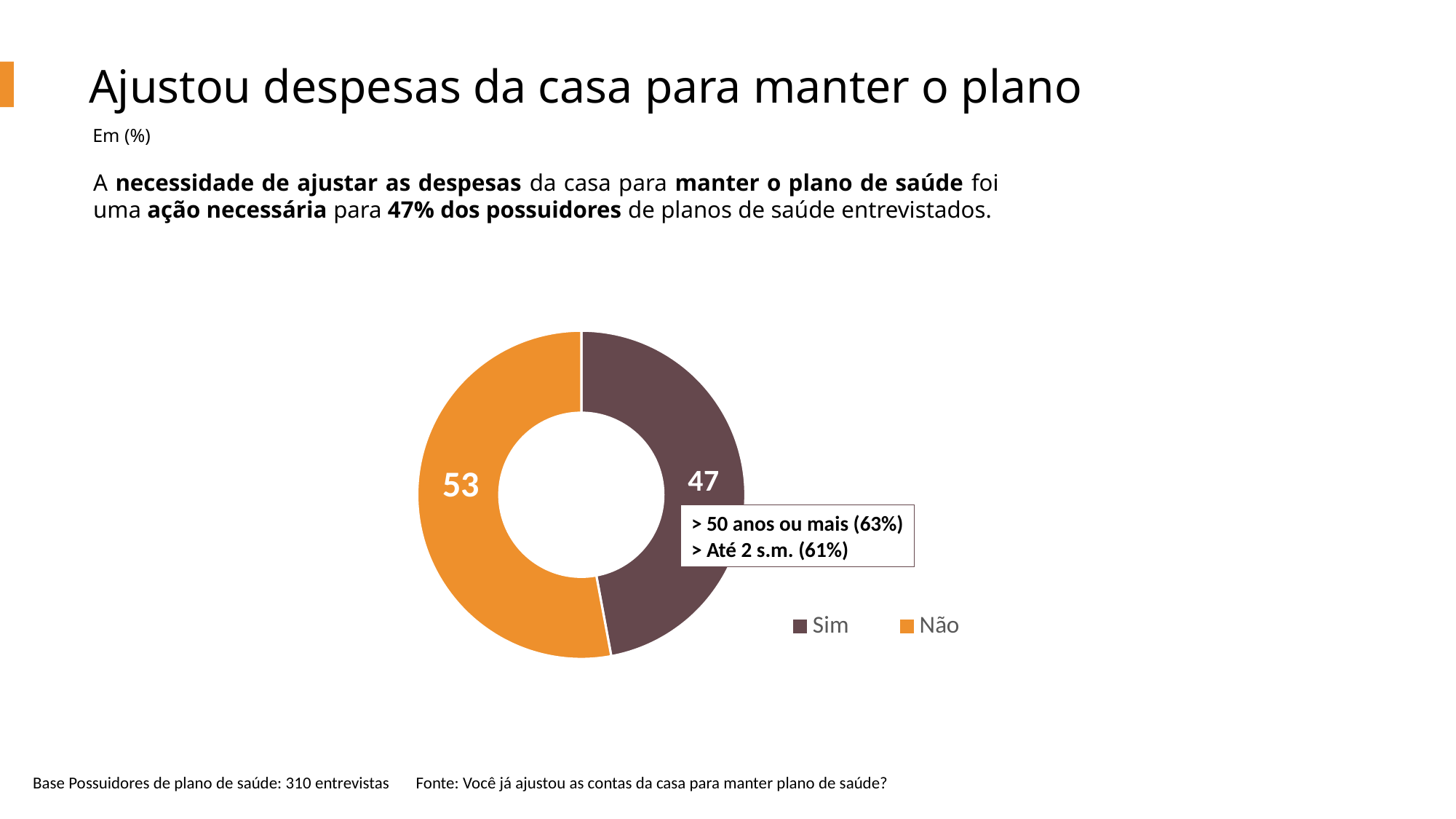
How many categories does the chart show? 2 How many entries does the legend list? 2 What is the total of the two values shown in the chart? 100 What is the value for Sim? 47 Which category has the smallest share of the chart? Sim Which is larger, the value for Sim or the value for Não? Não What is the title of the slide containing the chart? Ajustou despesas da casa para manter o plano Which category has the largest share of the chart? Não What is the value for Não? 53 What kind of chart is shown on the slide? Doughnut (pie) chart What colour is the Sim slice? Dark brown/purple What is the difference between the values for Não and Sim? 6